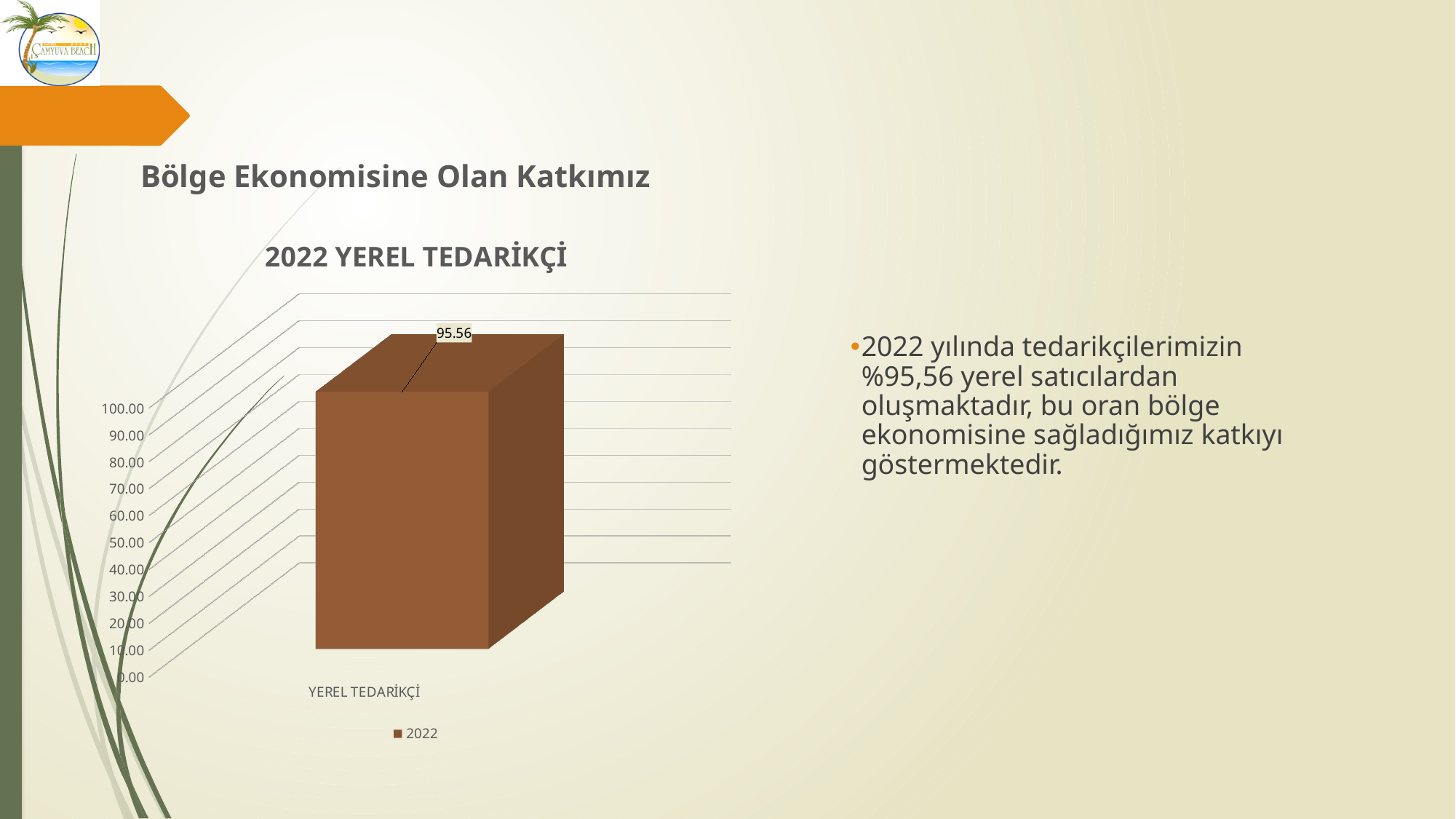
What kind of chart is shown on the slide? bar chart What series name does the chart legend show? 2022 How many series does the legend of the chart list? 1 Is the value for YEREL TEDARİKÇİ greater or less than 100.00? less How many categories are plotted in the 2022 YEREL TEDARİKÇİ chart? 1 What is the title of the chart on the slide? 2022 YEREL TEDARİKÇİ What is the highest value shown on the vertical axis of the chart? 100.00 Is the value for YEREL TEDARİKÇİ greater or less than 90.00? greater What is the value for YEREL TEDARİKÇİ in the 2022 YEREL TEDARİKÇİ chart? 95.56